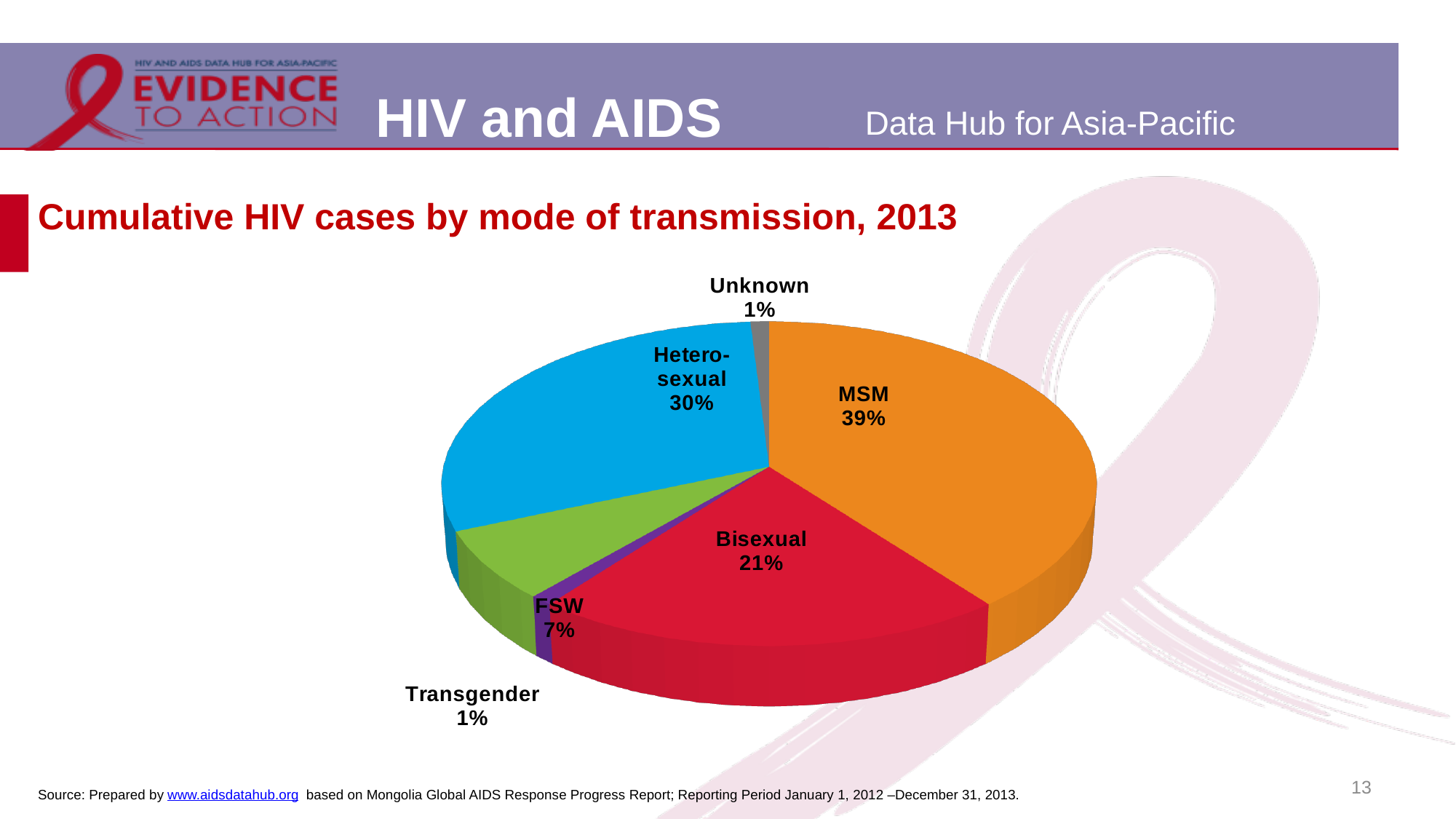
Which mode of transmission accounts for the largest share of cumulative HIV cases? MSM What share of cumulative HIV cases is attributed to FSW? 7% What colour is the MSM slice of the pie chart? Orange What share of cumulative HIV cases is attributed to MSM? 39% What share of cumulative HIV cases is attributed to heterosexual transmission? 30% What kind of chart is used on this slide? Pie chart What is the difference in percentage points between the bisexual and FSW shares? 14 What share of cumulative HIV cases is attributed to bisexual transmission? 21% What is the difference in percentage points between the MSM and heterosexual shares? 9 Which is larger, the share for heterosexual transmission or the share for bisexual transmission? Heterosexual What is the title of the chart on this slide? Cumulative HIV cases by mode of transmission, 2013 How many modes of transmission are shown in the pie chart? 6